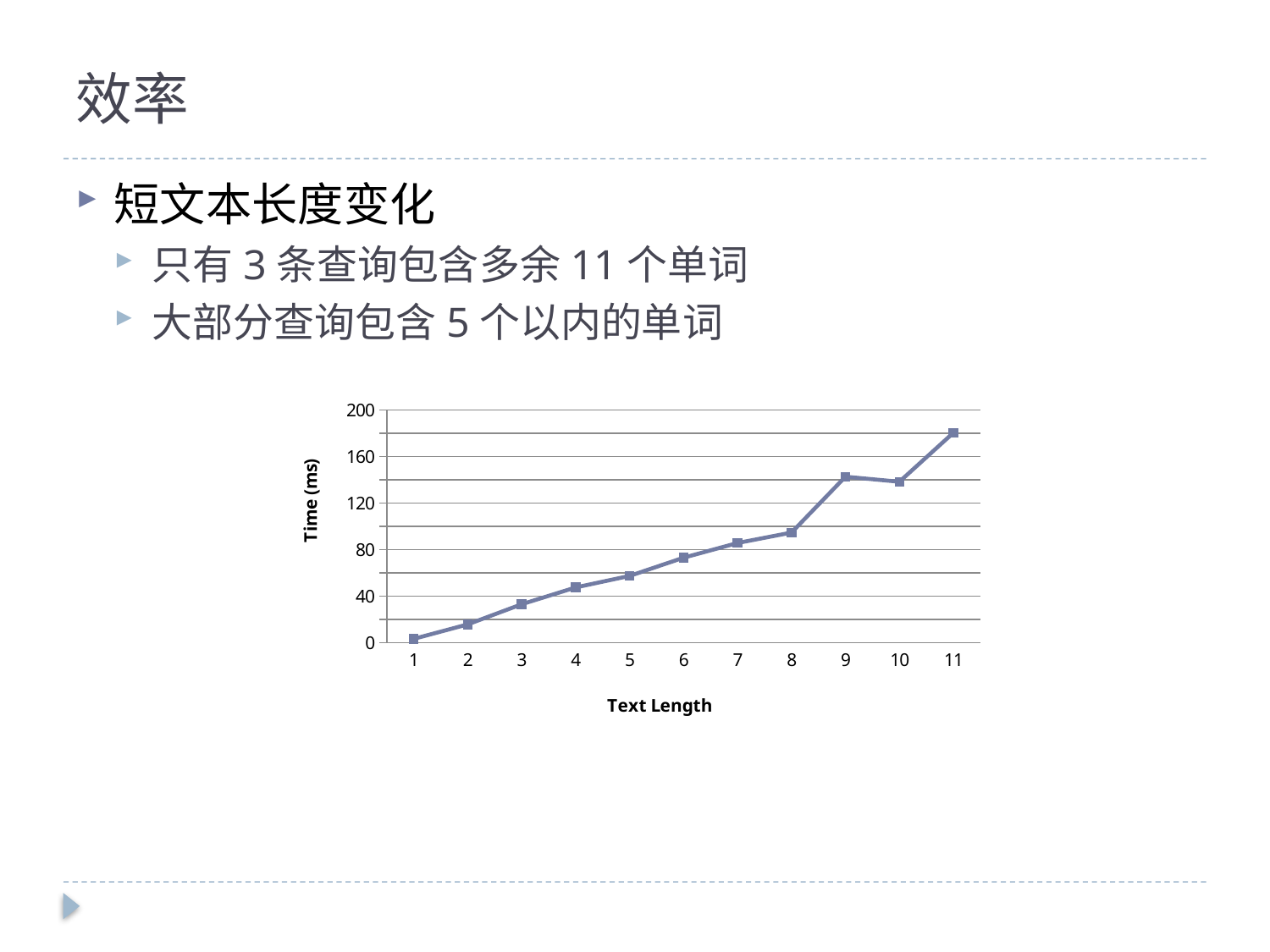
What is the label of the x axis? Text Length What kind of chart is shown on the slide? line chart Is the time for text length 9 greater or less than 120 ms? greater Is the time for text length 11 greater or less than 160 ms? greater Overall, does the time rise or fall as text length increases? rise Is the time for text length 5 greater or less than 80 ms? less Which has a larger time value, text length 11 or text length 9? 11 How many data points are plotted on the line chart? 11 At which text length is the time lowest? 1 At which text length is the time highest? 11 What is the label of the y axis? Time (ms)